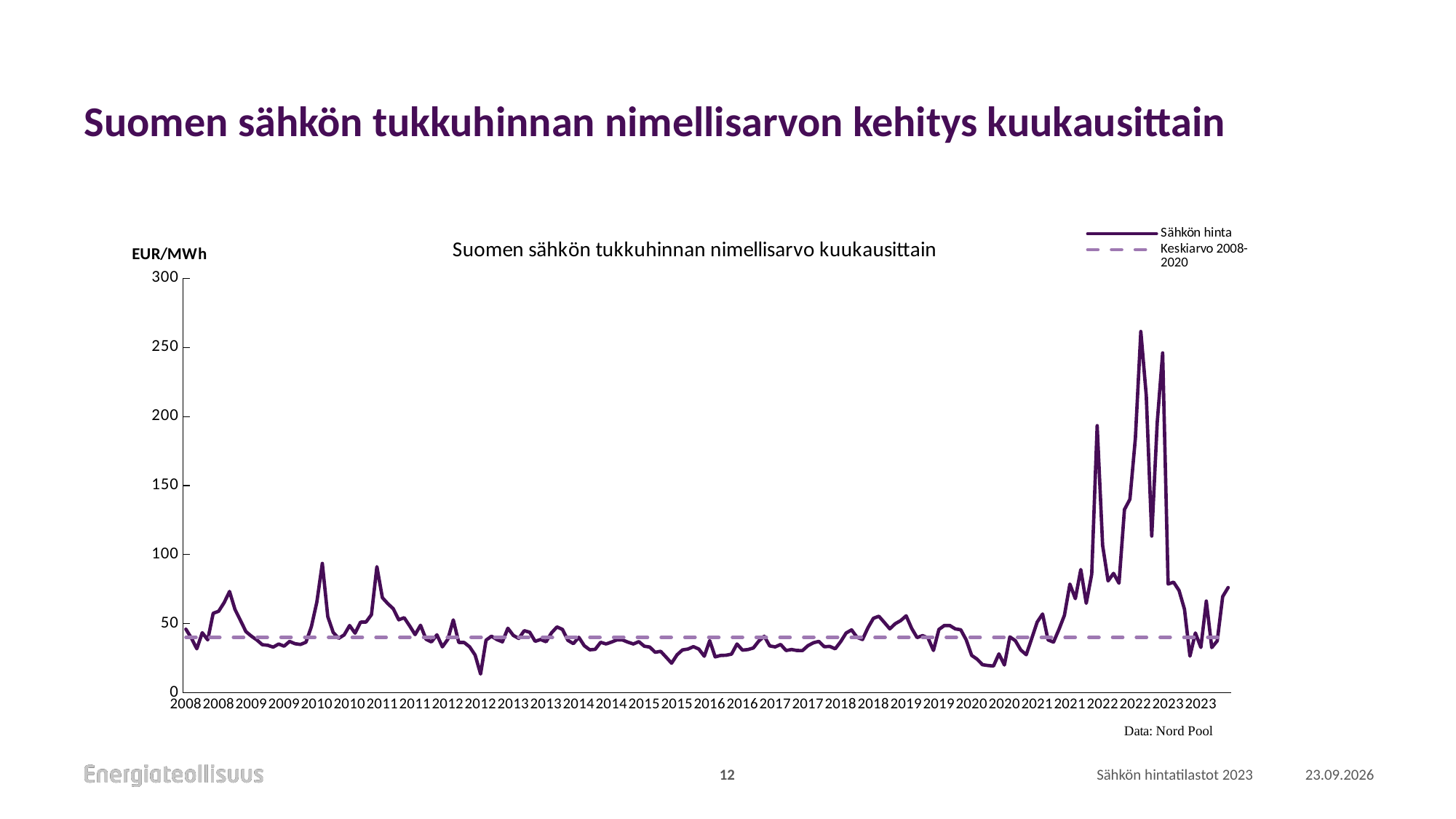
What kind of chart is shown on the slide? line chart What unit is shown on the y axis? EUR/MWh Is the lowest value of the Sähkön hinta line in 2012 greater or less than 50? less Is the peak of the Sähkön hinta line in 2010 greater or less than 150? less Is the highest peak of the Sähkön hinta line greater or less than 200? greater In which year does the Sähkön hinta line reach its lowest value? 2012 Which is larger: the peak of the Sähkön hinta line in 2022 or its peak in 2010? 2022 What are the two series named in the legend? Sähkön hinta; Keskiarvo 2008-2020 How many series does the legend list? 2 In which year does the Sähkön hinta line reach its highest value? 2022 Does the Sähkön hinta line generally rise or fall from 2020 to 2022? rise